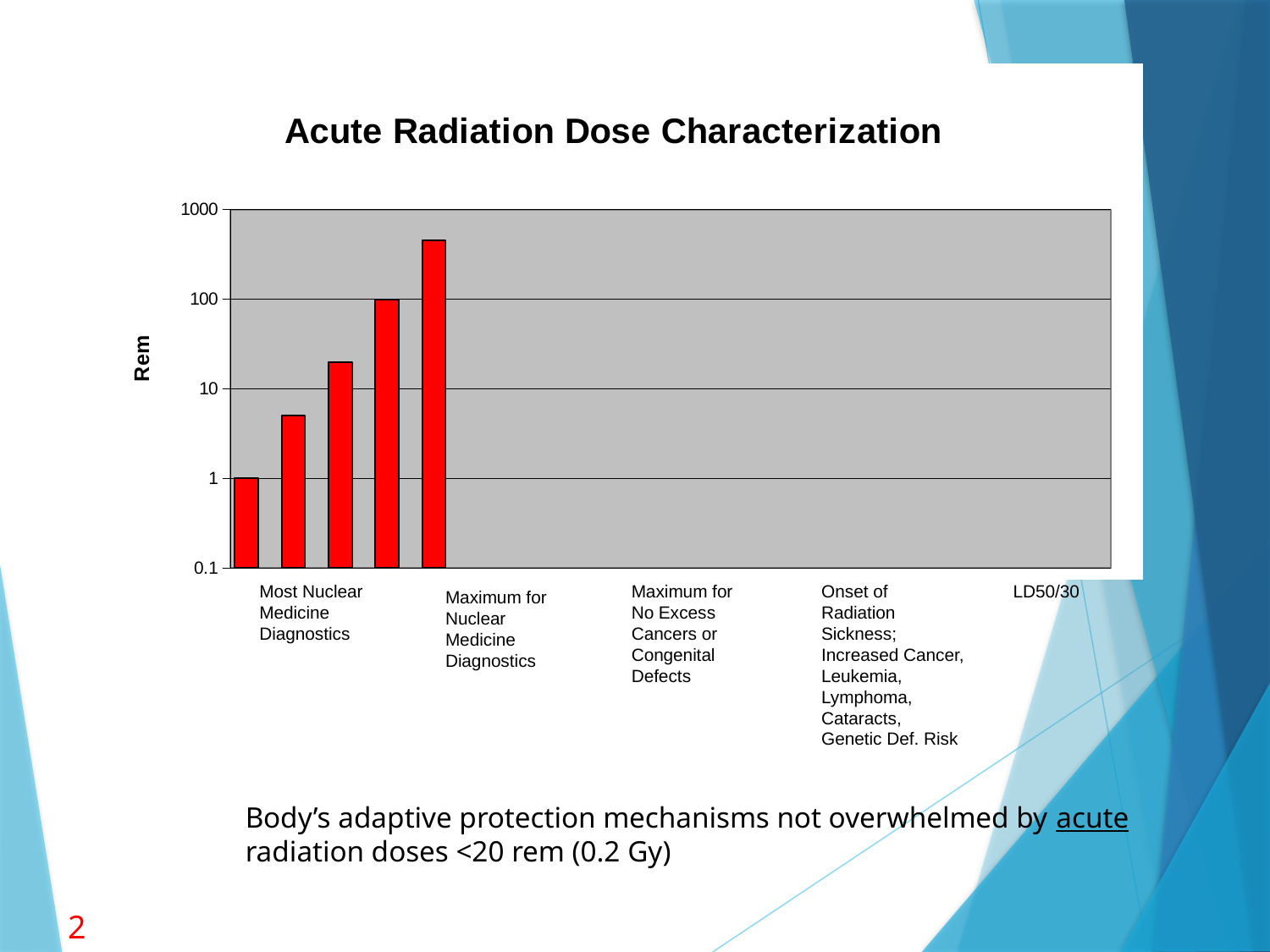
Which category has the lowest value? Most Nuclear Medicine Diagnostics How many bars are plotted in the chart? 5 Is the value for Maximum for No Excess Cancers or Congenital Defects greater or less than 10? greater What is the value in rem for Onset of Radiation Sickness; Increased Cancer, Leukemia, Lymphoma, Cataracts, Genetic Def. Risk? 100 What type of chart is shown on the slide? bar chart What is the value in rem for Most Nuclear Medicine Diagnostics? 1 What is the label on the vertical axis of the chart? Rem Is the value for LD50/30 greater or less than 100? greater Is the value for Maximum for Nuclear Medicine Diagnostics greater or less than 10? less What is the title of the chart? Acute Radiation Dose Characterization Which category has the highest value? LD50/30 Do the bar values rise or fall from left to right across the categories? rise